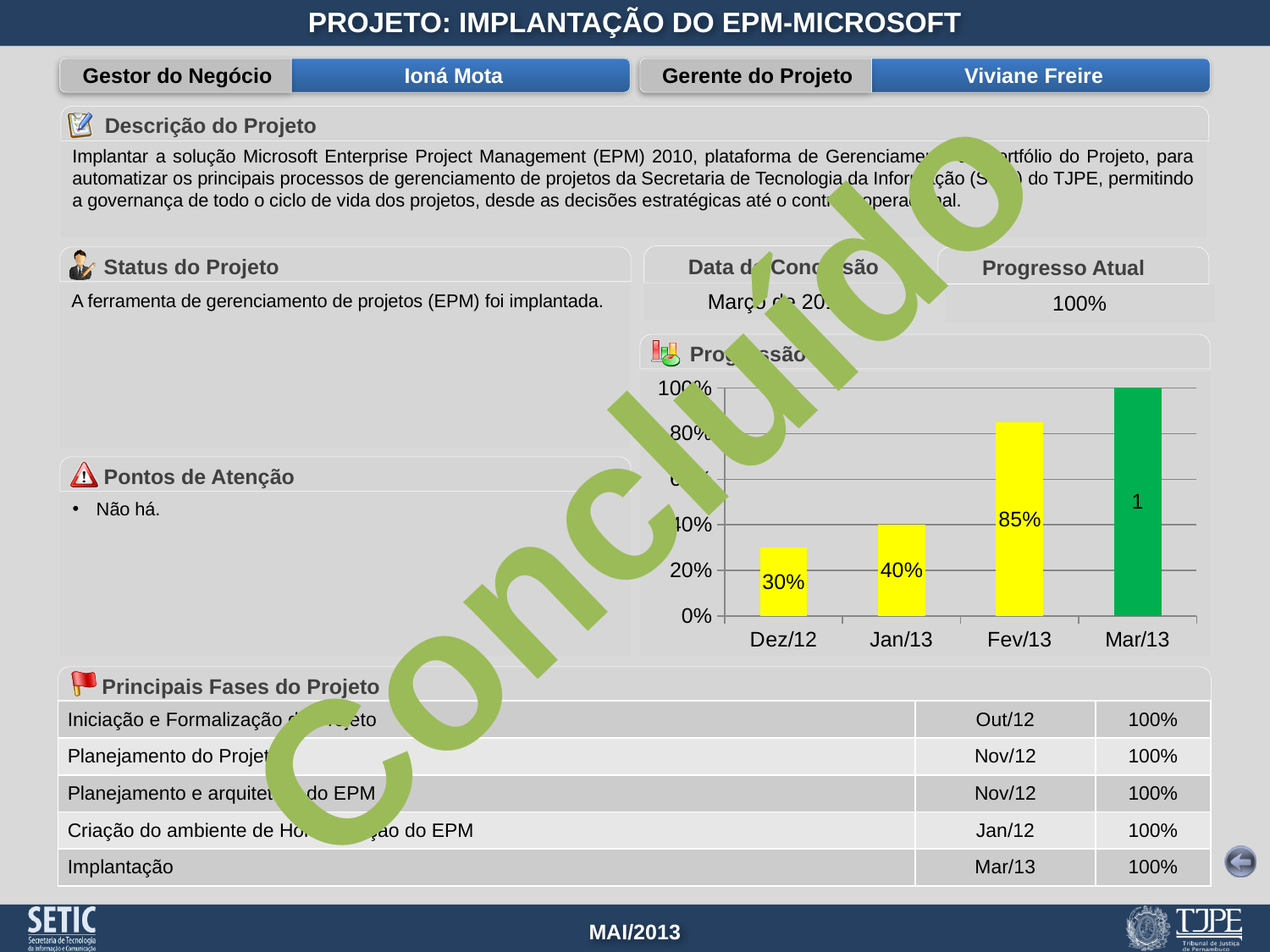
In the Progressão chart, what is the difference between the values for Fev/13 and Jan/13? 45% In the Progressão chart, is the value for Mar/13 greater or less than 80%? greater In the Progressão chart, which month has the highest bar? Mar/13 In the Progressão chart, what is the value for Fev/13? 85% In the Progressão chart, which is larger, the value for Fev/13 or the value for Dez/12? Fev/13 In the Progressão chart, what is the difference between the values for Jan/13 and Dez/12? 10% What type of chart is shown under the 'Progressão' heading? bar chart In the Progressão chart, what is the value for Jan/13? 40% Do the values in the Progressão chart rise or fall from Dez/12 to Mar/13? rise How many months are shown on the x axis of the Progressão chart? 4 In the Progressão chart, what is the value for Dez/12? 30% In the Progressão chart, which month has the lowest value? Dez/12